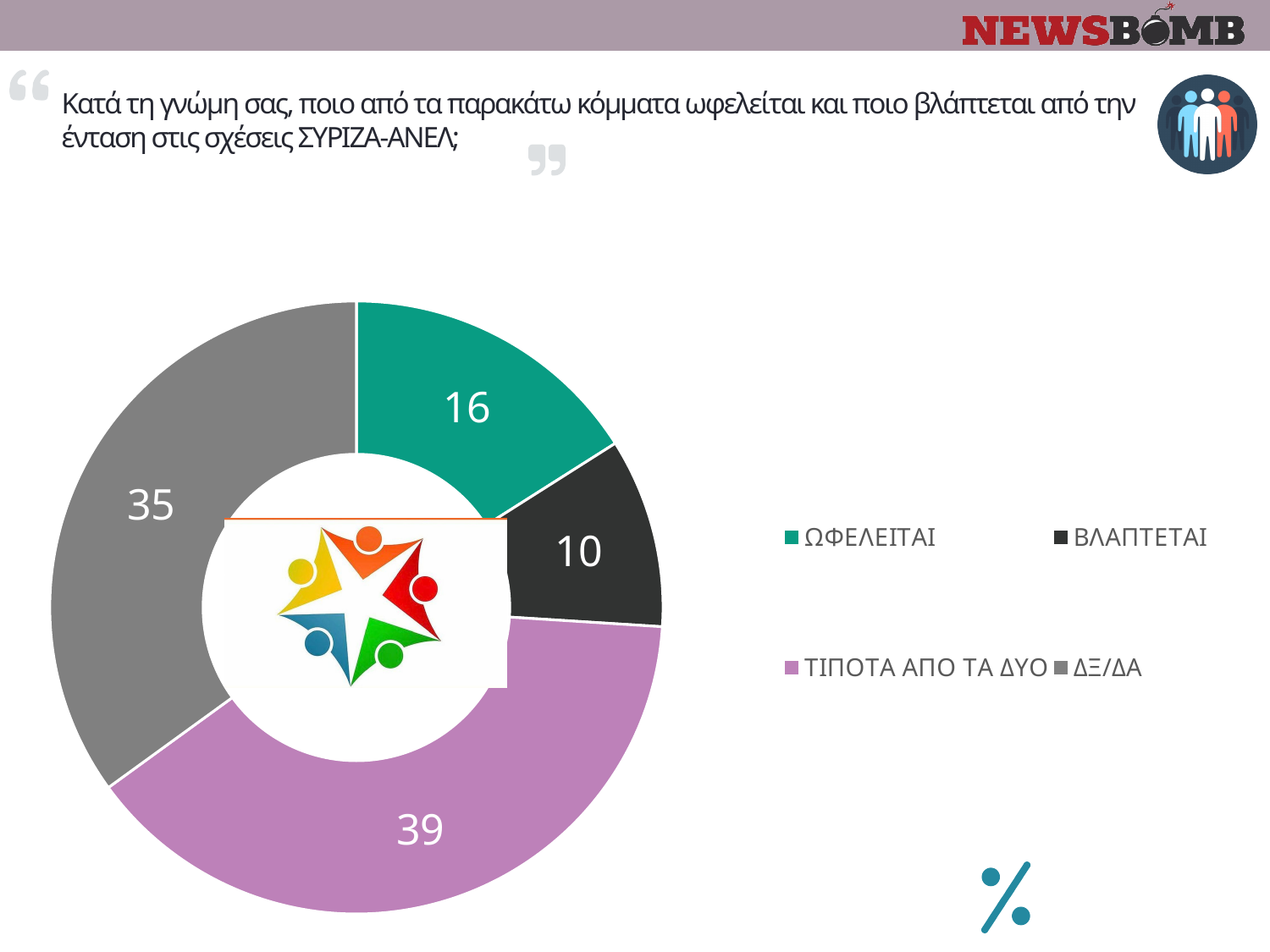
What colour is the ΔΞ/ΔΑ slice in the chart? grey Which category has the smallest slice in the chart? ΒΛΑΠΤΕΤΑΙ What value is shown for ΤΙΠΟΤΑ ΑΠΟ ΤΑ ΔΥΟ in the chart? 39 How many categories does the chart show? 4 What is the difference between the values for ΤΙΠΟΤΑ ΑΠΟ ΤΑ ΔΥΟ and ΔΞ/ΔΑ? 4 Which category has the largest slice in the chart? ΤΙΠΟΤΑ ΑΠΟ ΤΑ ΔΥΟ What kind of chart is shown on the slide? doughnut (pie) chart What value is shown for ΔΞ/ΔΑ in the chart? 35 Which is larger, the value for ΩΦΕΛΕΙΤΑΙ or the value for ΒΛΑΠΤΕΤΑΙ? ΩΦΕΛΕΙΤΑΙ What value is shown for ΒΛΑΠΤΕΤΑΙ in the chart? 10 What value is shown for ΩΦΕΛΕΙΤΑΙ in the chart? 16 What is the difference between the values for ΩΦΕΛΕΙΤΑΙ and ΒΛΑΠΤΕΤΑΙ? 6